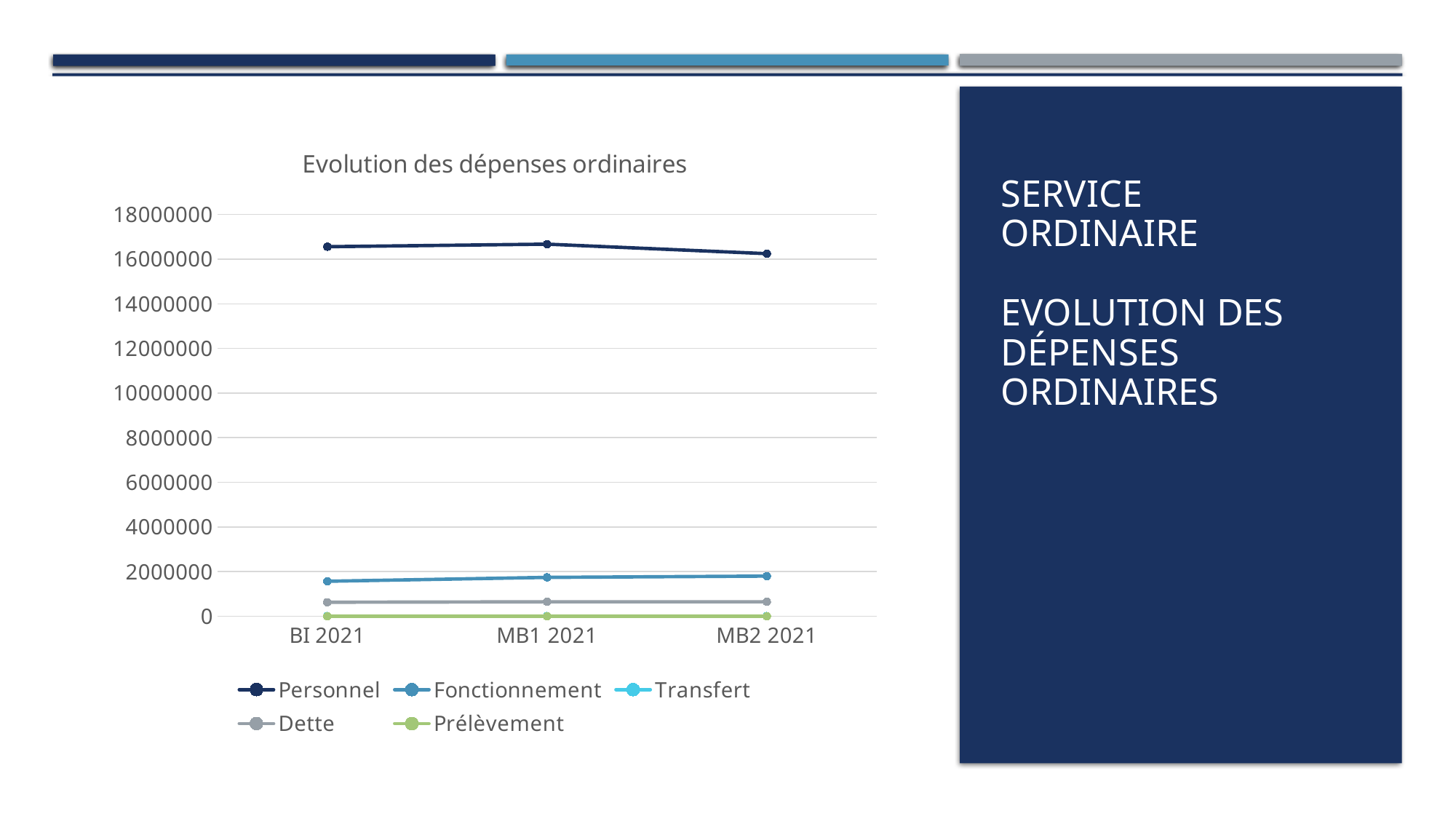
Which is larger at MB1 2021, Personnel or Fonctionnement? Personnel What kind of chart is shown on the slide? line chart Is the value for Fonctionnement at MB2 2021 greater or less than 4000000? less How many categories are shown on the x axis of the chart? 3 Does the Fonctionnement series rise or fall from BI 2021 to MB2 2021? rise How many series does the chart legend list? 5 Which series has the highest values in the chart? Personnel Which series is drawn in green in the chart? Prélèvement What is the title of the chart? Evolution des dépenses ordinaires Which is larger at BI 2021, Fonctionnement or Dette? Fonctionnement Is the value for Dette at MB1 2021 greater or less than 2000000? less Is the value for Personnel at BI 2021 greater or less than 14000000? greater